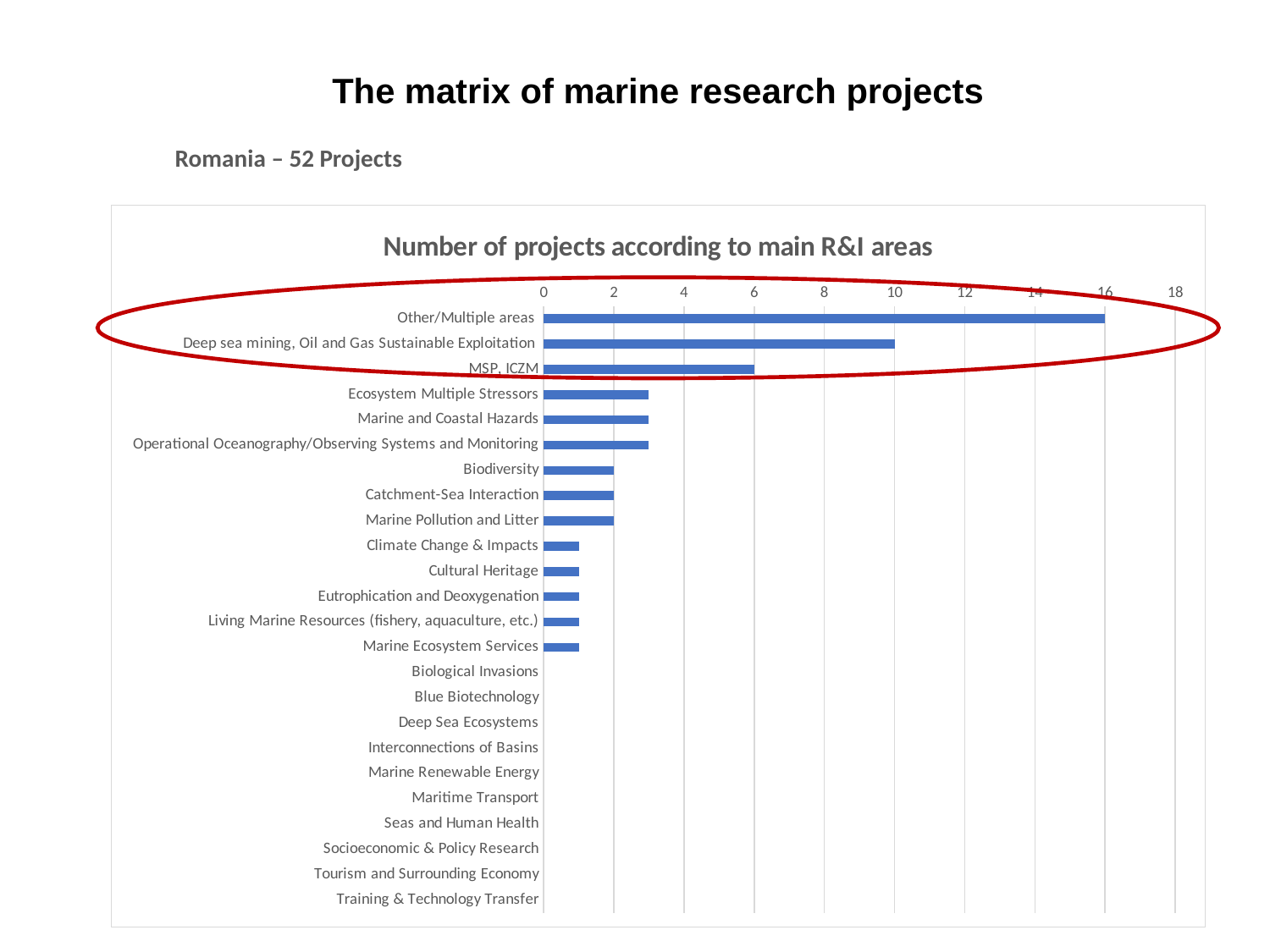
What is the title of the chart? Number of projects according to main R&I areas How many projects are in the MSP, ICZM category? 6 How many projects are in the Biodiversity category? 2 What is the difference in the number of projects between Other/Multiple areas and Deep sea mining, Oil and Gas Sustainable Exploitation? 6 How many R&I area categories are listed on the chart's axis? 24 Which R&I area has the highest number of projects? Other/Multiple areas What type of chart is shown on the slide? bar chart Which has more projects, MSP, ICZM or Marine Pollution and Litter? MSP, ICZM Is the value for Climate Change & Impacts greater or less than 2? less How many projects are in the Deep sea mining, Oil and Gas Sustainable Exploitation category? 10 Is the value for Ecosystem Multiple Stressors greater or less than 4? less How many projects are in the Other/Multiple areas category? 16